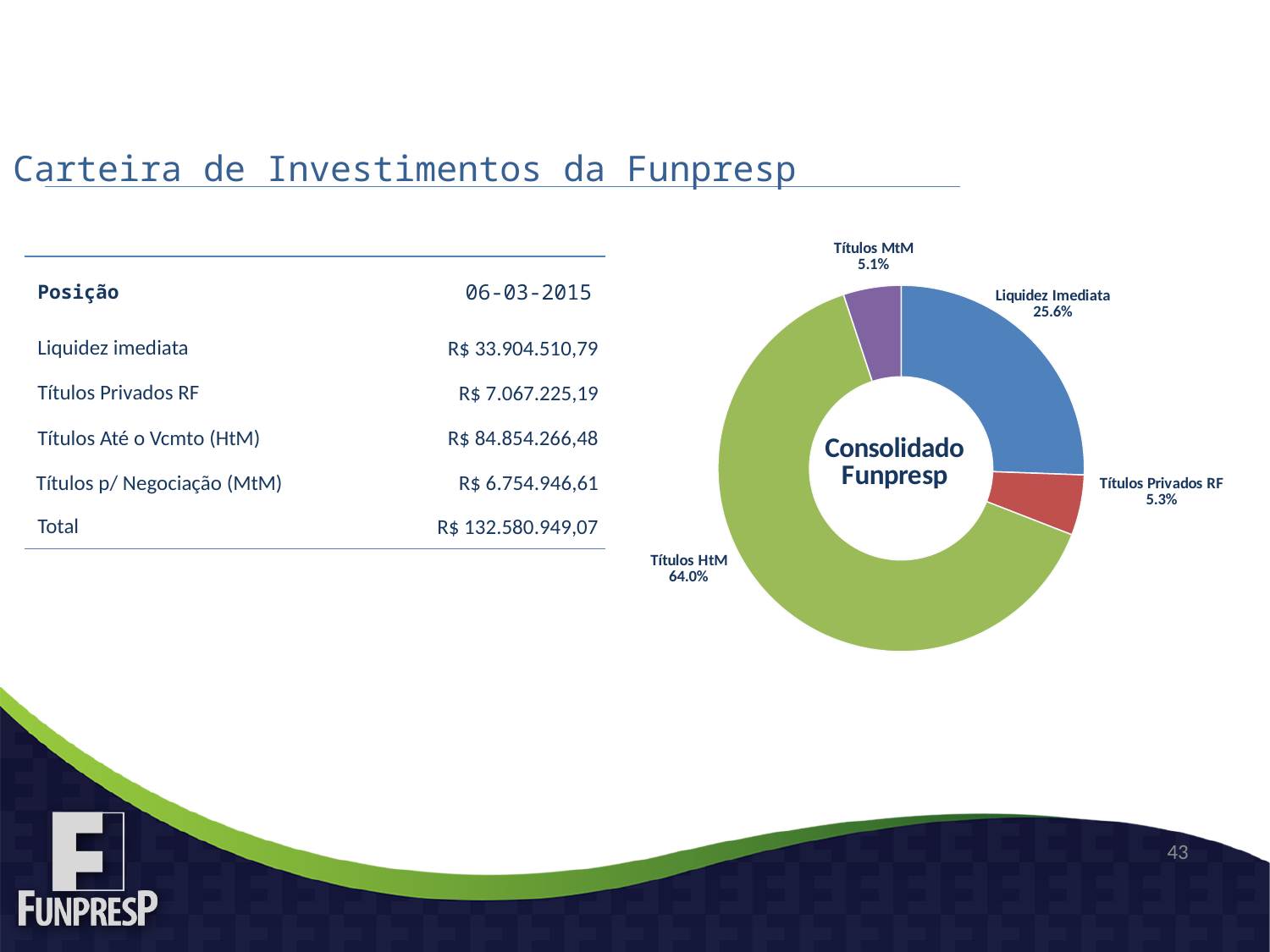
What colour is the Títulos HtM slice in the chart? Green Which category has the largest share in the chart? Títulos HtM Which is larger in the chart: Liquidez Imediata or Títulos Privados RF? Liquidez Imediata What is the difference in percentage points between Títulos HtM and Liquidez Imediata? 38.4 Which category has the smallest share in the chart? Títulos MtM What percentage is shown for Liquidez Imediata in the chart? 25.6% What percentage is shown for Títulos Privados RF in the chart? 5.3% What share of the doughnut chart does Títulos HtM represent? 64.0% What kind of chart is shown on the slide? Doughnut chart What text appears in the centre of the doughnut chart? Consolidado Funpresp What percentage is shown for Títulos MtM in the chart? 5.1% How many categories are shown in the chart? 4